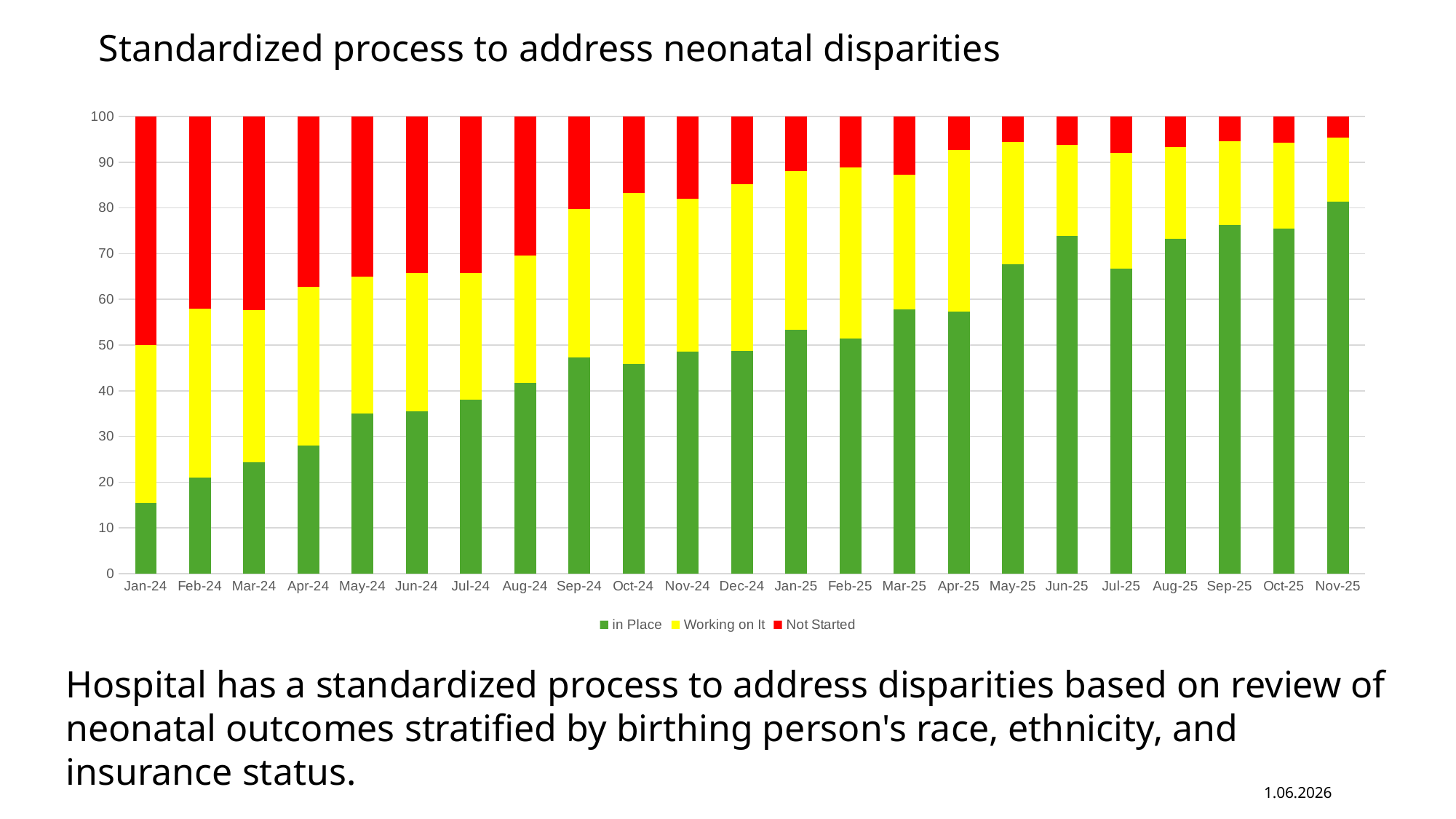
Which month has the highest 'in Place' value? Nov-25 Is the 'in Place' value for Nov-25 greater or less than 70? greater How many months are shown along the x axis? 23 Is the 'in Place' value for Sep-24 greater or less than 50? less What kind of chart is shown on the slide? Stacked bar chart Which month has the lowest 'in Place' value? Jan-24 Does the 'in Place' series generally rise or fall from Jan-24 to Nov-25? rise What is the total height of the stacked bar for Jan-24? 100 Is the 'in Place' value for Jan-24 greater or less than 20? less How many series does the legend list? 3 Which has the larger 'in Place' value, Jun-25 or Jul-25? Jun-25 Which month has the largest 'Not Started' segment? Jan-24